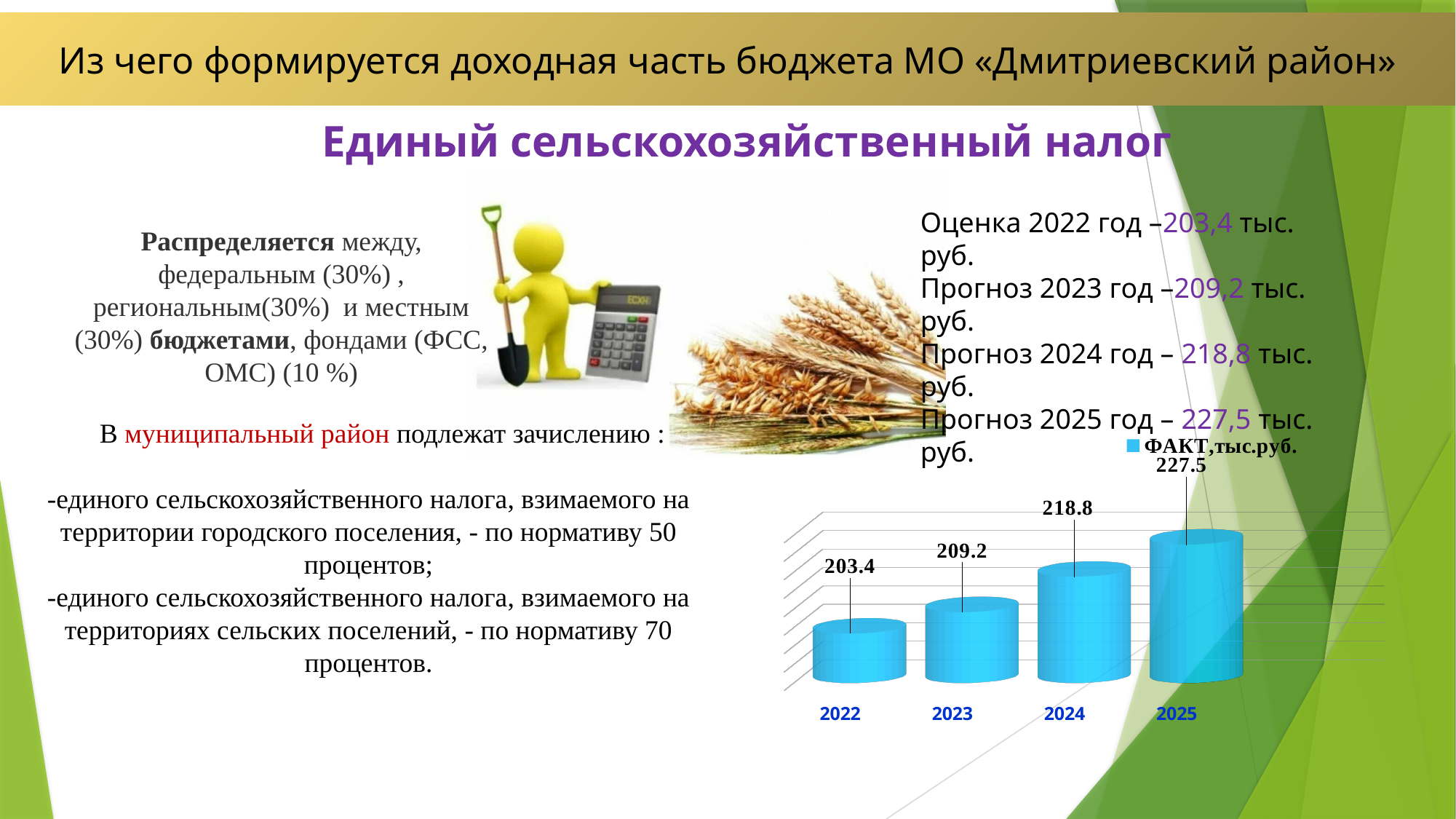
Which year has the highest value in the chart? 2025 Which year has the lowest value in the chart? 2022 How many years are shown in the chart? 4 What is the difference between the values for 2024 and 2023? 9.6 What is the value for 2025 in the chart? 227.5 What is the value for 2022 in the chart? 203.4 What is the value for 2024 in the chart? 218.8 How many series does the chart legend list? 1 Which is larger, the value for 2023 or the value for 2024? 2024 What is the difference between the values for 2025 and 2022? 24.1 What is the value for 2023 in the chart? 209.2 Do the values rise or fall from 2022 to 2025? rise